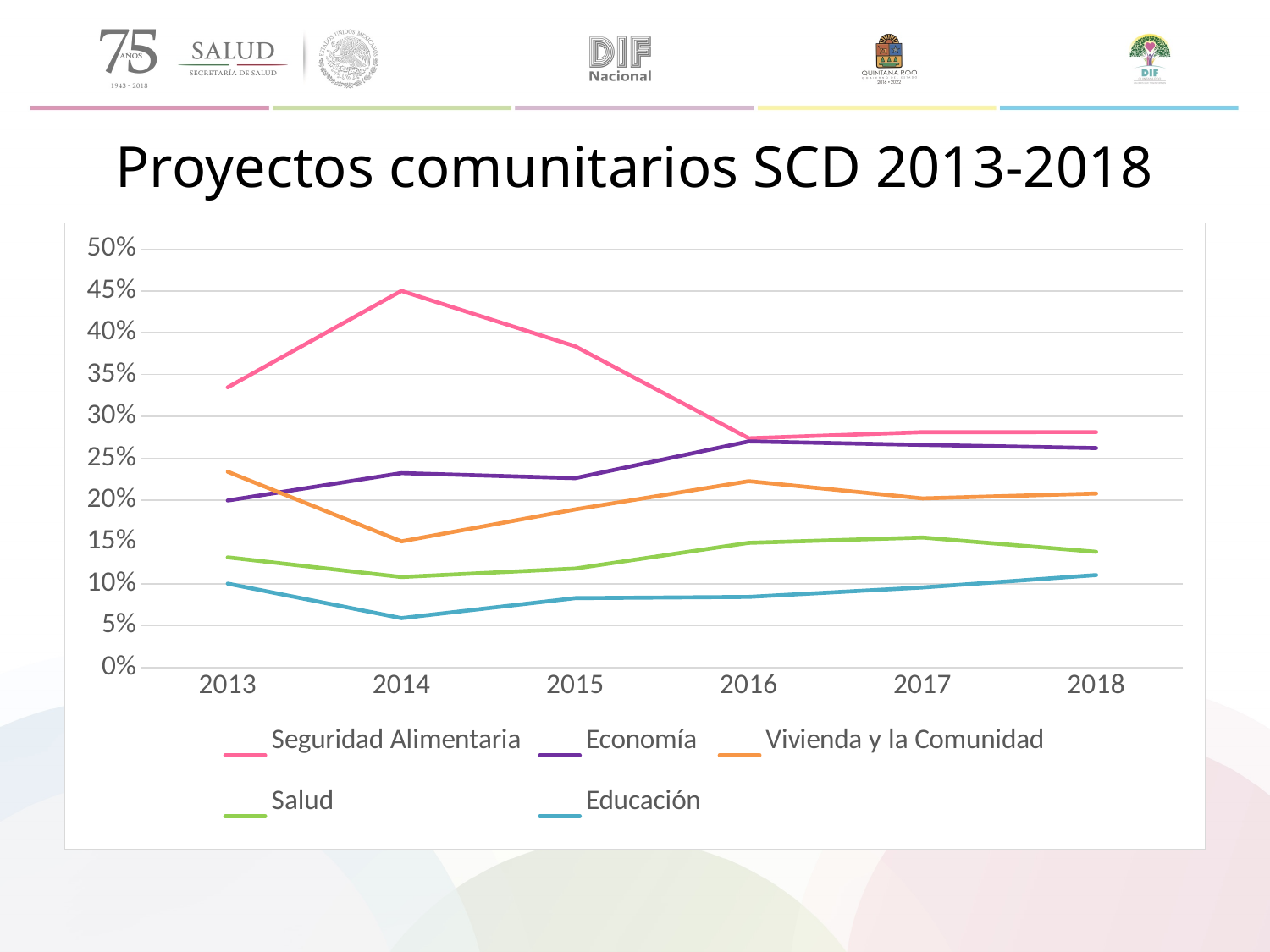
In which year is Educación at its lowest value? 2014 In 2013, which is larger: Economía or Vivienda y la Comunidad? Vivienda y la Comunidad In 2018, which is larger: Salud or Educación? Salud Is the value for Seguridad Alimentaria in 2014 greater or less than 40%? greater What kind of chart is shown on the slide? Line chart Does the Educación line rise or fall from 2014 to 2018? Rises How many years are shown on the x axis? 6 How many series does the legend list? 5 Which series has the highest value in 2013? Seguridad Alimentaria In which year does Seguridad Alimentaria reach its highest value? 2014 Is the value for Vivienda y la Comunidad in 2014 greater or less than 20%? less Is the value for Educación in 2014 greater or less than 10%? less